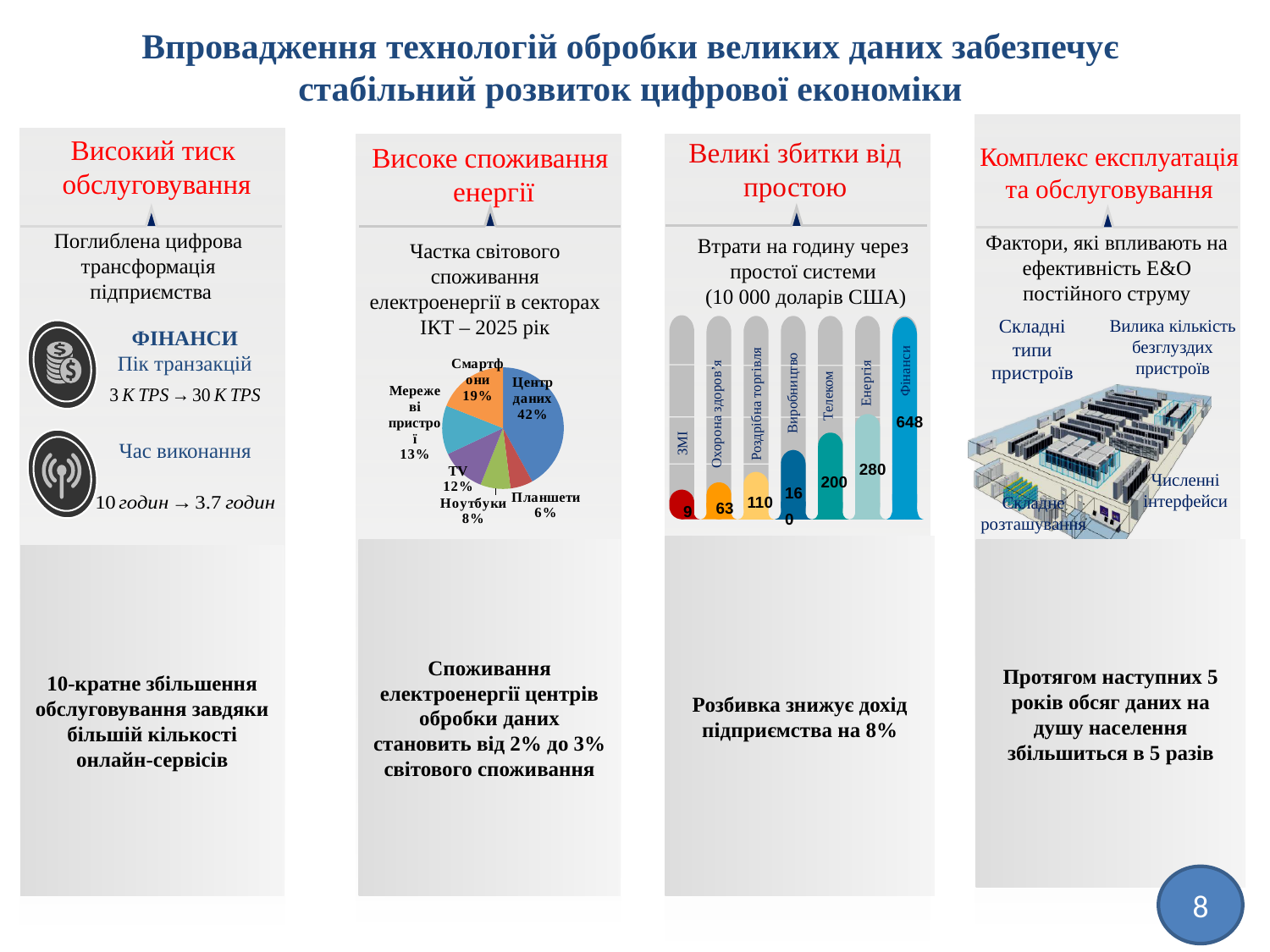
In the pie chart on the slide, what is the difference between the shares of Мережеві пристрої and TV? 1% In the pie chart on the slide, which category has the largest share? Центр даних What kind of chart is used to show losses per hour due to system downtime on the slide? Bar chart In the pie chart on the slide, what share is shown for Смартфони? 19% In the pie chart on the slide, how many categories are shown? 6 In the bar chart on the slide, which is larger: the value for Телеком or the value for Енергія? Енергія In the pie chart on the slide, which category has the smallest share? Планшети In the bar chart on the slide, which category has the lowest value? ЗМІ In the bar chart on the slide (losses per hour due to system downtime), what is the value for Фінанси? 648 In the pie chart on the slide (share of world electricity consumption in ICT sectors, 2025), what share is shown for Центр даних? 42% In the bar chart on the slide, what is the value for Охорона здоров'я? 63 In the bar chart on the slide, what is the difference between the values for Енергія and Роздрібна торгівля? 170